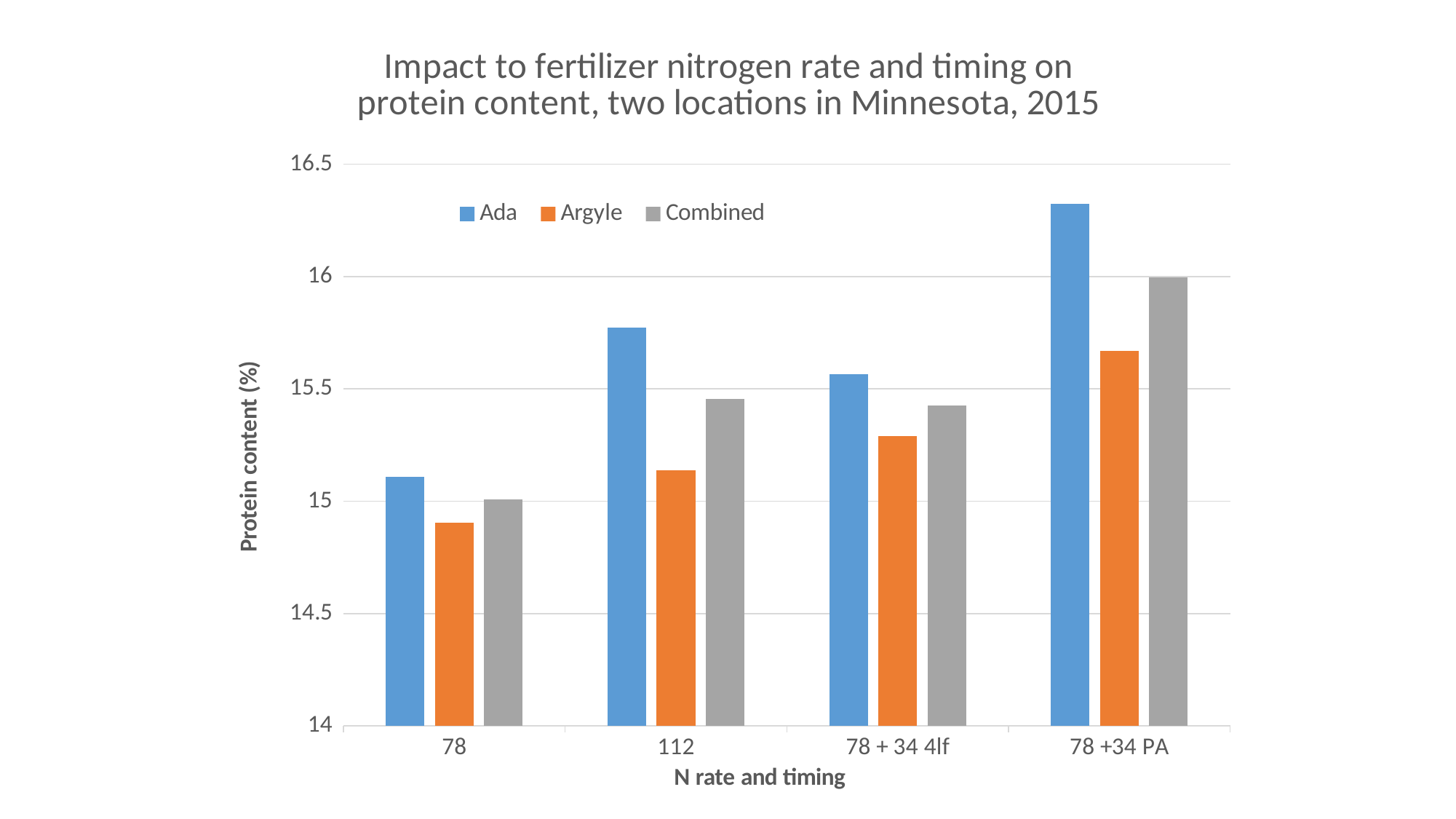
Is the Ada value for 78 +34 PA greater or less than 16? greater How many N rate and timing categories are shown on the x axis? 4 Is the Argyle value for 78 +34 PA greater or less than 15.5? greater What is the label of the vertical axis? Protein content (%) Is the Argyle value for 112 greater or less than 15.5? less For which N rate and timing category is the Ada protein content highest? 78 +34 PA For which N rate and timing category is the Argyle protein content lowest? 78 How many series does the legend list? 3 At the 112 N rate, which is larger: the Ada value or the Argyle value? Ada What kind of chart is shown on the slide? bar chart